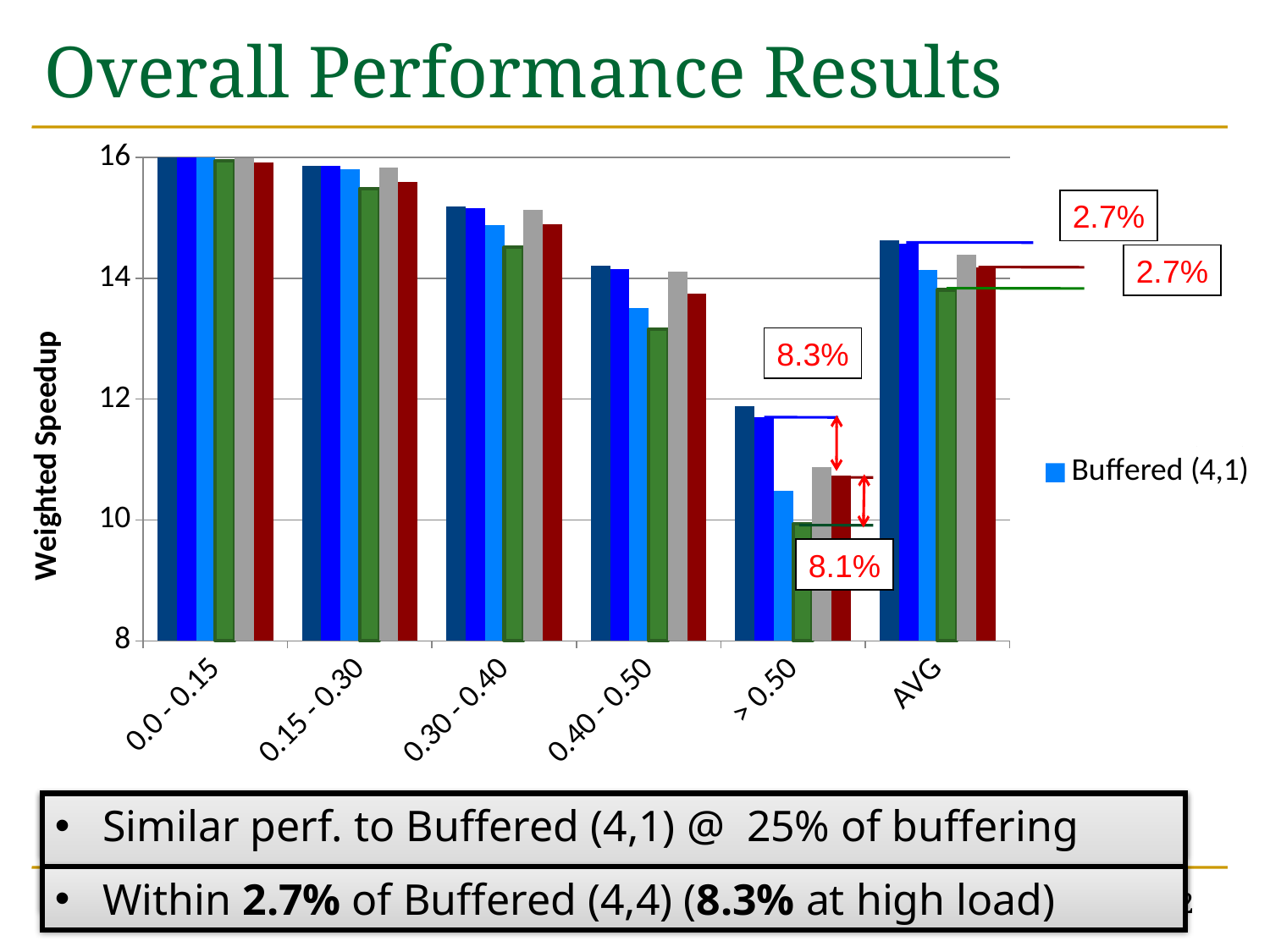
How many categories are shown along the x axis of the chart? 6 Which category has the highest weighted speedup values? 0.0 - 0.15 Do the weighted speedup values rise or fall from the 0.0 - 0.15 category to the > 0.50 category? fall What is the label of the y axis of the chart? Weighted Speedup Is the Buffered (4,1) value for the 0.40 - 0.50 category greater or less than 14? less Which is larger for Buffered (4,1): the value for 0.0 - 0.15 or the value for > 0.50? 0.0 - 0.15 Is the Buffered (4,1) value for the 0.0 - 0.15 category greater or less than 14? greater Which series name is readable in the chart's legend? Buffered (4,1) Is the Buffered (4,1) value for the > 0.50 category greater or less than 12? less What kind of chart is shown on the slide? bar chart Which category has the lowest weighted speedup values? > 0.50 What percentage gap is annotated above the > 0.50 category in the chart? 8.3%